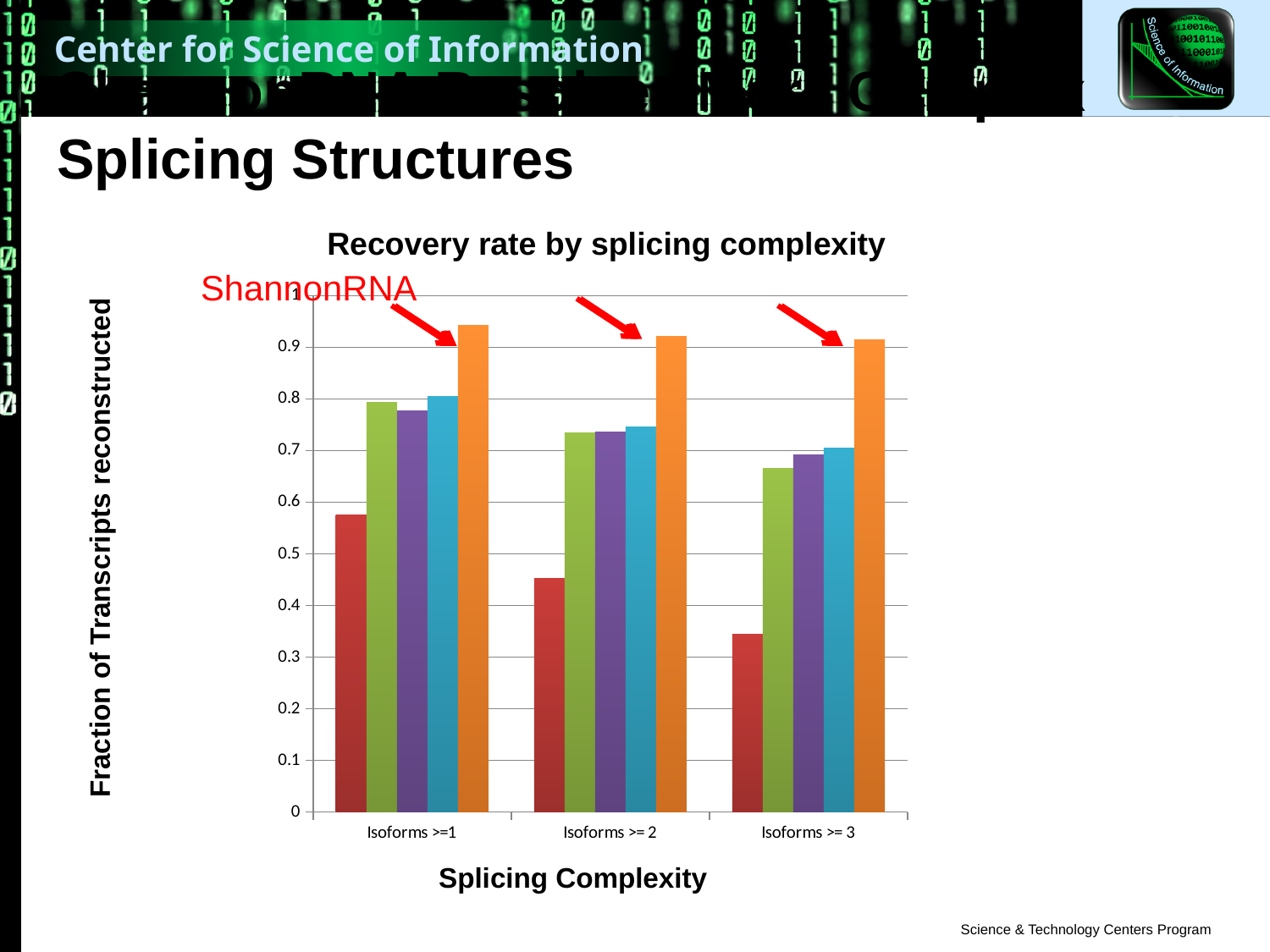
How many splicing complexity categories are shown on the x axis? 3 For Isoforms >= 2, which is larger: the ShannonRNA (orange) bar or the red bar? ShannonRNA (orange) bar For which splicing complexity category is the red bar lowest? Isoforms >= 3 What kind of chart is shown on the slide? bar chart Is the ShannonRNA (orange) value for Isoforms >=1 greater or less than 0.9? greater What is the title of the chart? Recovery rate by splicing complexity Is the red bar for Isoforms >= 2 greater or less than 0.5? less How many bars are plotted for each splicing complexity category? 5 Is the red bar for Isoforms >= 3 greater or less than 0.4? less Do the red bars rise or fall as splicing complexity increases from Isoforms >=1 to Isoforms >= 3? fall What is the label of the y axis? Fraction of Transcripts reconstructed